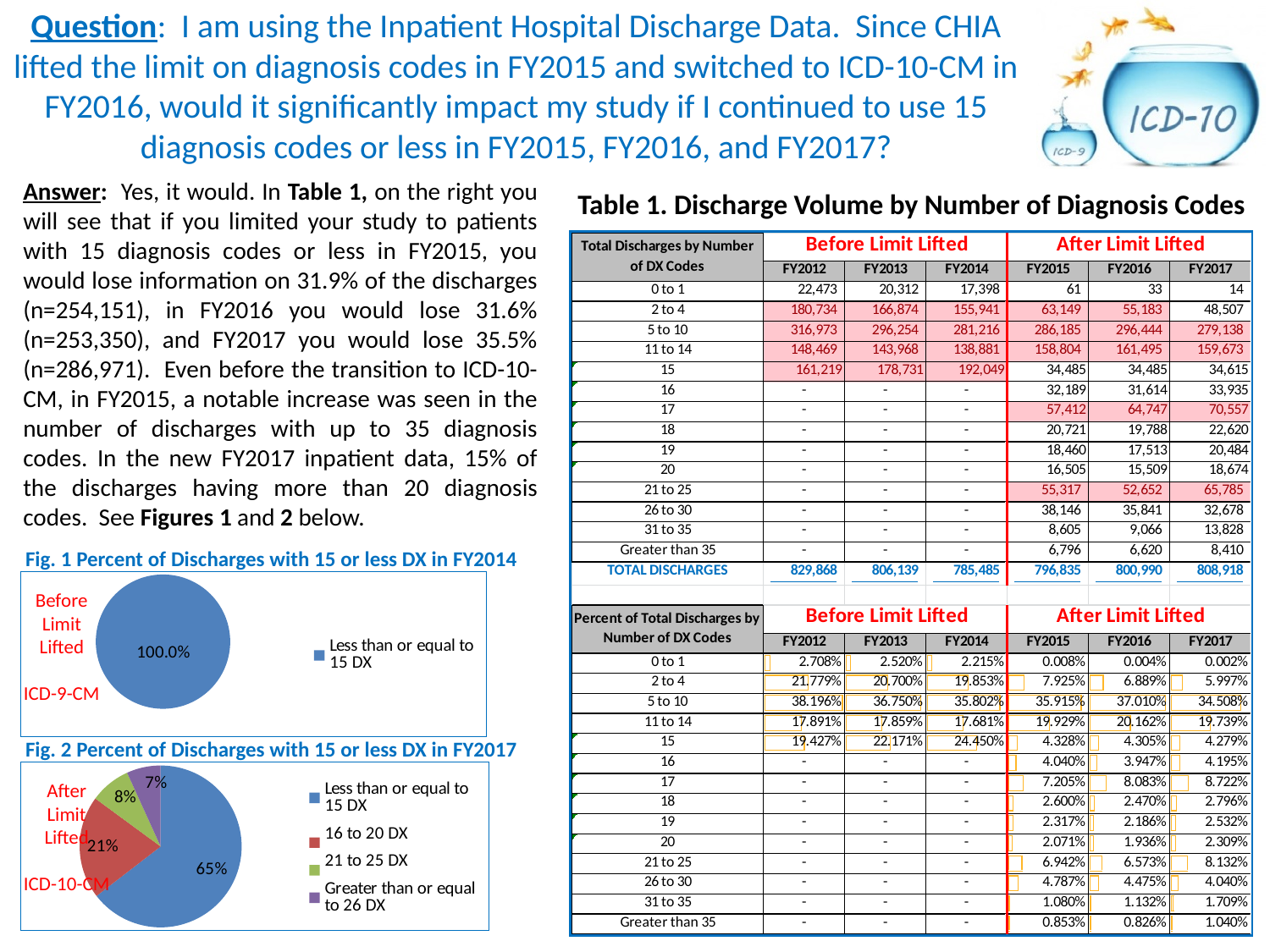
How many slices does the Fig. 2 (FY2017) pie chart have? 4 In Fig. 2 (FY2017 pie chart), which category has the largest slice? Less than or equal to 15 DX In Fig. 2 (FY2017 pie chart), what is the difference in percentage points between the 'Less than or equal to 15 DX' slice and the '16 to 20 DX' slice? 44% In Fig. 2 (FY2017 pie chart), what percentage is shown for 21 to 25 DX? 8% In Fig. 2 (FY2017 pie chart), which category has the smallest slice? Greater than or equal to 26 DX In Fig. 1 (Percent of Discharges with 15 or less DX in FY2014), what percentage is shown for the single slice? 100.0% In Fig. 2 (FY2017 pie chart), what percentage of discharges had greater than or equal to 26 DX? 7% In Fig. 2 (FY2017 pie chart), which is larger: the share for 16 to 20 DX or the share for 21 to 25 DX? 16 to 20 DX In Fig. 2 (FY2017 pie chart), what share of discharges had 16 to 20 DX? 21% In Fig. 2 (Percent of Discharges with 15 or less DX in FY2017), what percentage of discharges had less than or equal to 15 DX? 65% How many legend entries does Fig. 1 (FY2014 pie chart) list? 1 What type of chart is Fig. 2 (Percent of Discharges with 15 or less DX in FY2017)? Pie chart